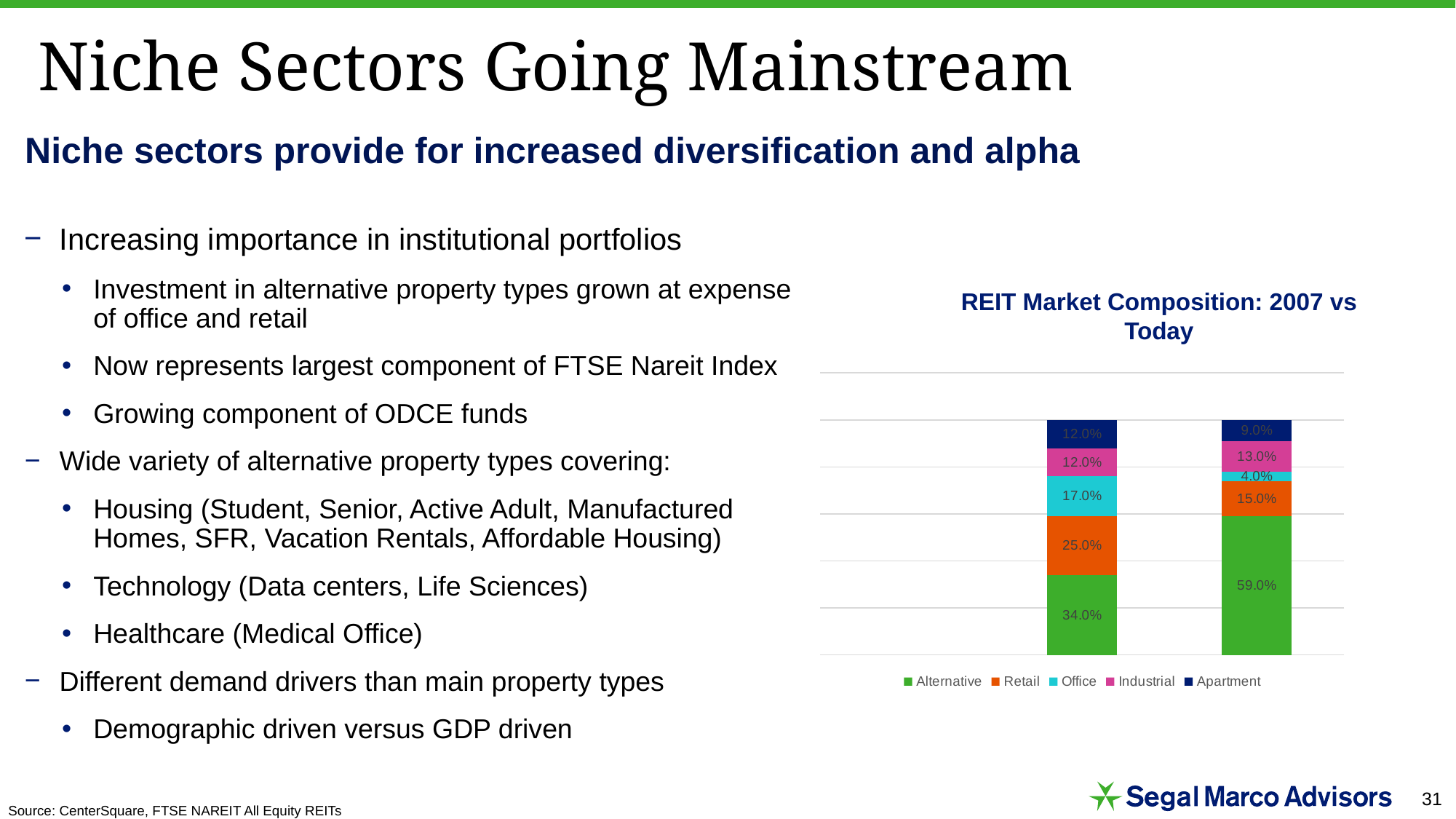
What is the Office value in the right bar of the chart? 4.0% What is the title of the chart? REIT Market Composition: 2007 vs Today What is the Alternative value in the left bar of the chart? 34.0% How many stacked bars are plotted in the chart? 2 Which segment is the largest in the right bar of the chart? Alternative What is the Retail value in the left bar of the chart? 25.0% What is the difference between the Alternative value in the right bar and the Alternative value in the left bar? 25.0% What kind of chart is shown on the slide? stacked bar chart Which is larger: the Retail value in the left bar or the Retail value in the right bar? left bar Which segment is the smallest in the right bar of the chart? Office What is the Alternative value in the right bar of the chart? 59.0% How many series does the chart's legend list? 5